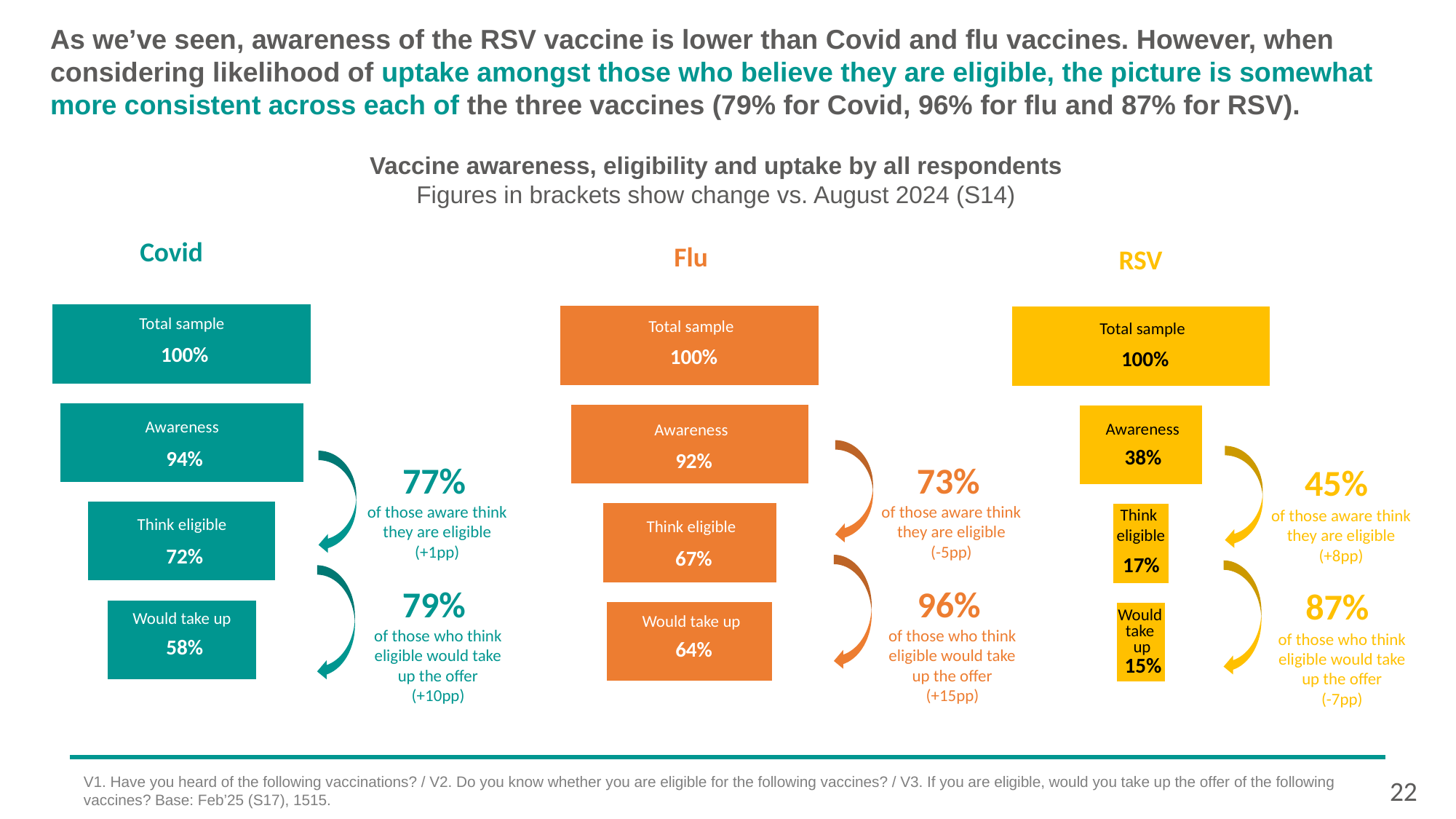
In the Covid funnel, what is the difference between the Awareness figure and the Think eligible figure? 22 percentage points What is the title of the chart on the slide? Vaccine awareness, eligibility and uptake by all respondents Across the three vaccine funnels, which vaccine has the highest share of those who think they are eligible who would take up the offer? Flu In the Covid funnel, what percentage of all respondents are aware of the vaccine? 94% In the RSV funnel, what is the change vs. August 2024 shown for the share of those aware who think they are eligible? +8pp In the Flu funnel, what percentage of all respondents would take up the vaccine? 64% What colour is used for the RSV funnel? Yellow Across the three vaccine funnels, which vaccine has the lowest awareness among all respondents? RSV Is the Would take up figure for all respondents higher for Covid or for Flu? Flu In the Flu funnel, what is the change vs. August 2024 shown for the share of those who think eligible who would take up the offer? +15pp How many stages (boxes) does each vaccine funnel show, from Total sample to Would take up? 4 In the RSV funnel, what percentage of all respondents think they are eligible? 17%